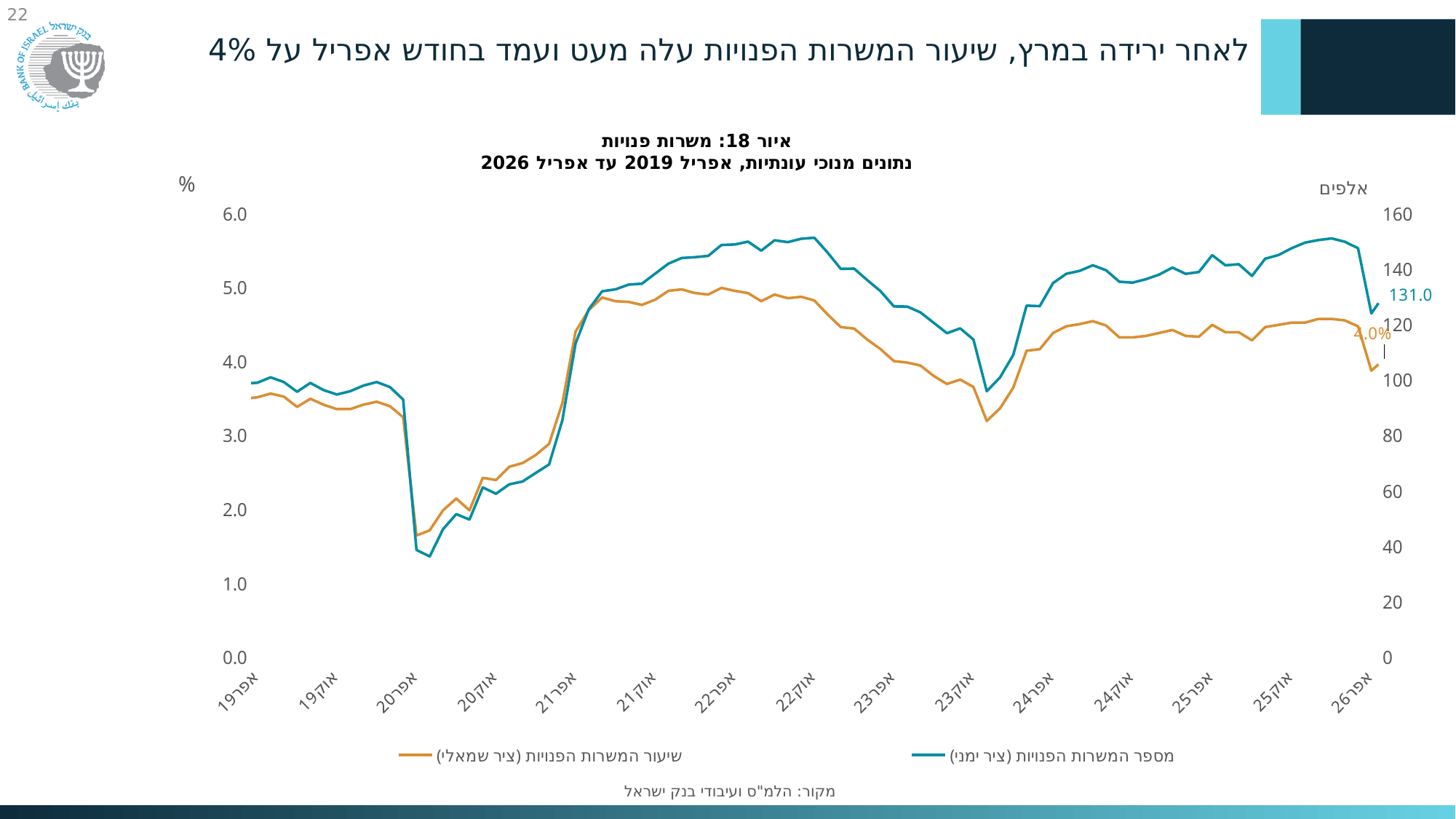
What is the last labelled value of the job vacancy rate series (שיעור המשרות הפנויות)? 4.0% Is the job vacancy rate (orange line) at אפר20 greater or less than 3.0? less What is the last labelled value of the number of job vacancies series (מספר המשרות הפנויות)? 131.0 What kind of chart is shown on the slide? line chart Is the job vacancy rate (orange line) at אפר19 greater or less than 4.0? less How many series does the legend list? 2 Between אפר20 and אפר21, does the number of job vacancies (teal line) rise or fall? rise What colour is the line for the job vacancy rate (שיעור המשרות הפנויות)? orange Is the number of job vacancies (teal line) at אוק22 greater or less than 140? greater Which series is plotted on the right axis according to the legend? מספר המשרות הפנויות Between אוק22 and אוק23, does the job vacancy rate (orange line) rise or fall? fall What is the maximum value shown on the right-hand axis? 160